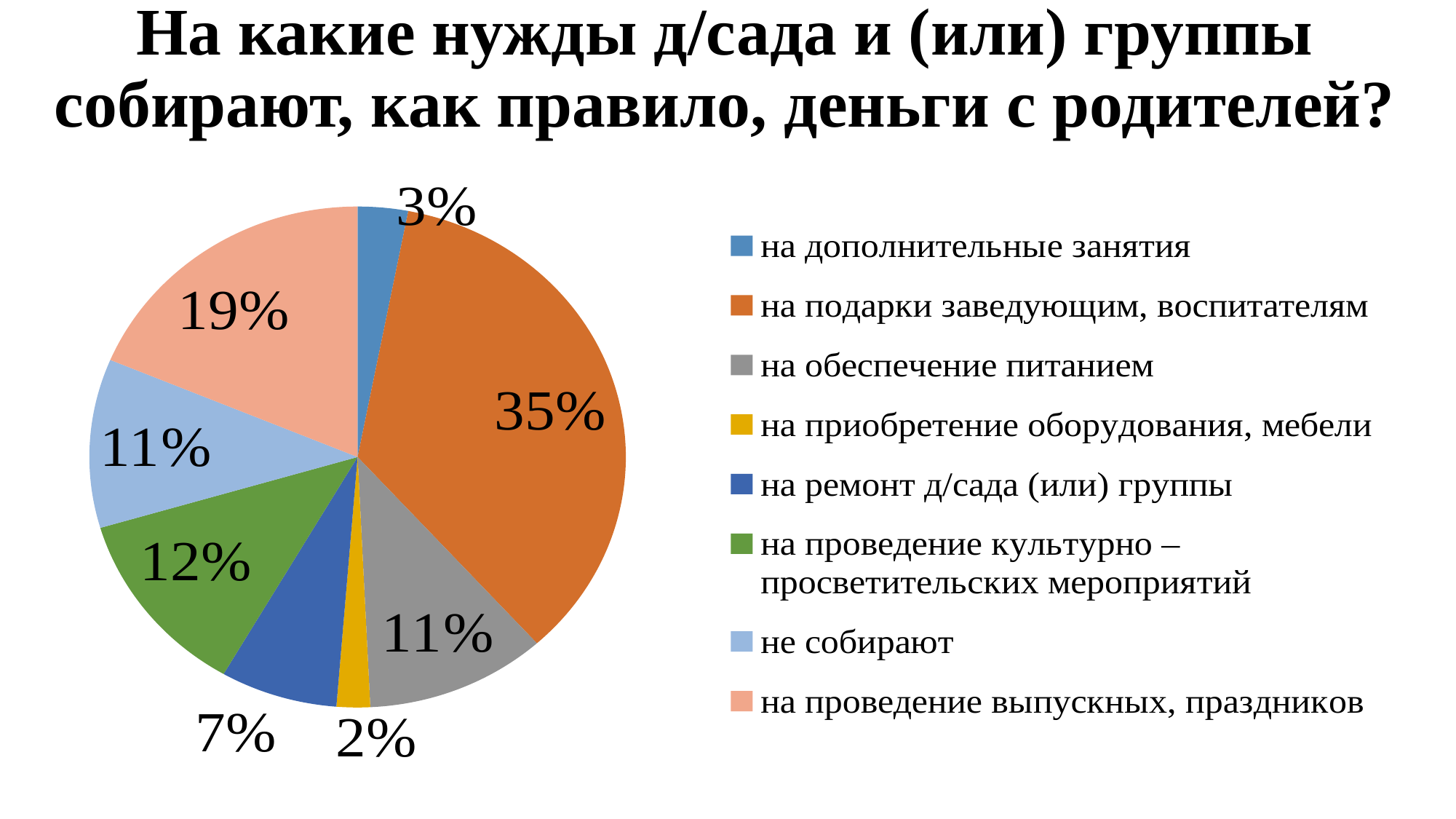
What percentage is shown for "не собирают"? 11% Which category has the largest slice of the pie? на подарки заведующим, воспитателям What colour is the slice for "на обеспечение питанием"? gray What percentage is shown for "на приобретение оборудования, мебели"? 2% What share of the pie is labelled for "на подарки заведующим, воспитателям"? 35% What type of chart is shown on the slide? pie chart Which category has the smallest slice of the pie? на приобретение оборудования, мебели How many categories does the pie chart have? 8 What percentage is shown for "на ремонт д/сада (или) группы"? 7% What is the difference in percentage points between "на подарки заведующим, воспитателям" and "на проведение выпускных, праздников"? 16 What percentage is shown for "на проведение выпускных, праздников"? 19% Which is larger: the share for "на проведение культурно – просветительских мероприятий" or the share for "на ремонт д/сада (или) группы"? на проведение культурно – просветительских мероприятий